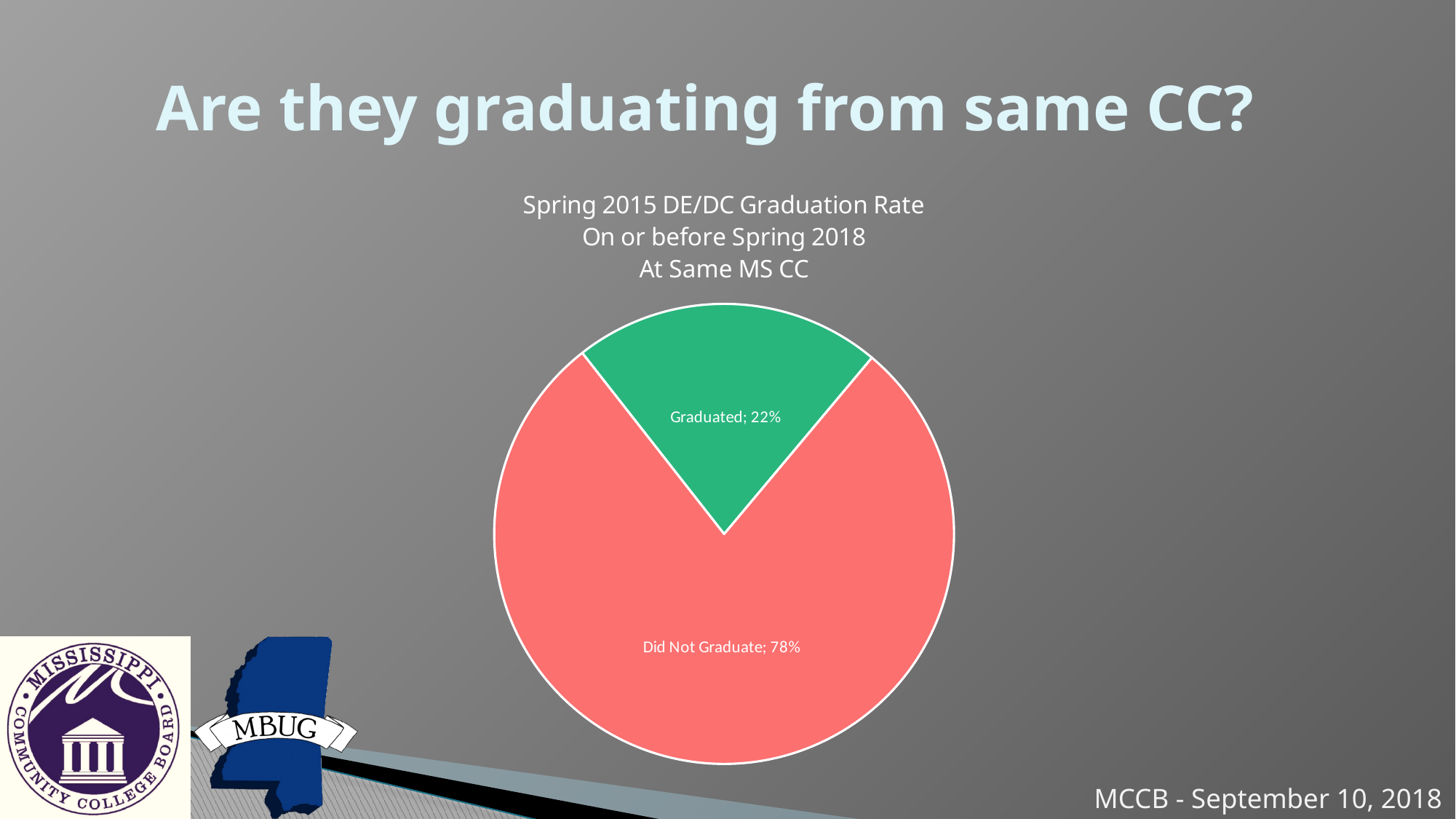
Which is larger, the Graduated slice or the Did Not Graduate slice? Did Not Graduate How many slices does the pie chart have? 2 What percentage of students Did Not Graduate? 78% What is the title of the pie chart? Spring 2015 DE/DC Graduation Rate On or before Spring 2018 At Same MS CC Which slice of the pie is the largest? Did Not Graduate What percentage of students Graduated? 22% Which slice of the pie is the smallest? Graduated What kind of chart is shown on the slide? pie chart What share of the pie does the Graduated slice represent? 22% What is the difference in percentage points between Did Not Graduate and Graduated? 56 What colour is the Graduated slice? green